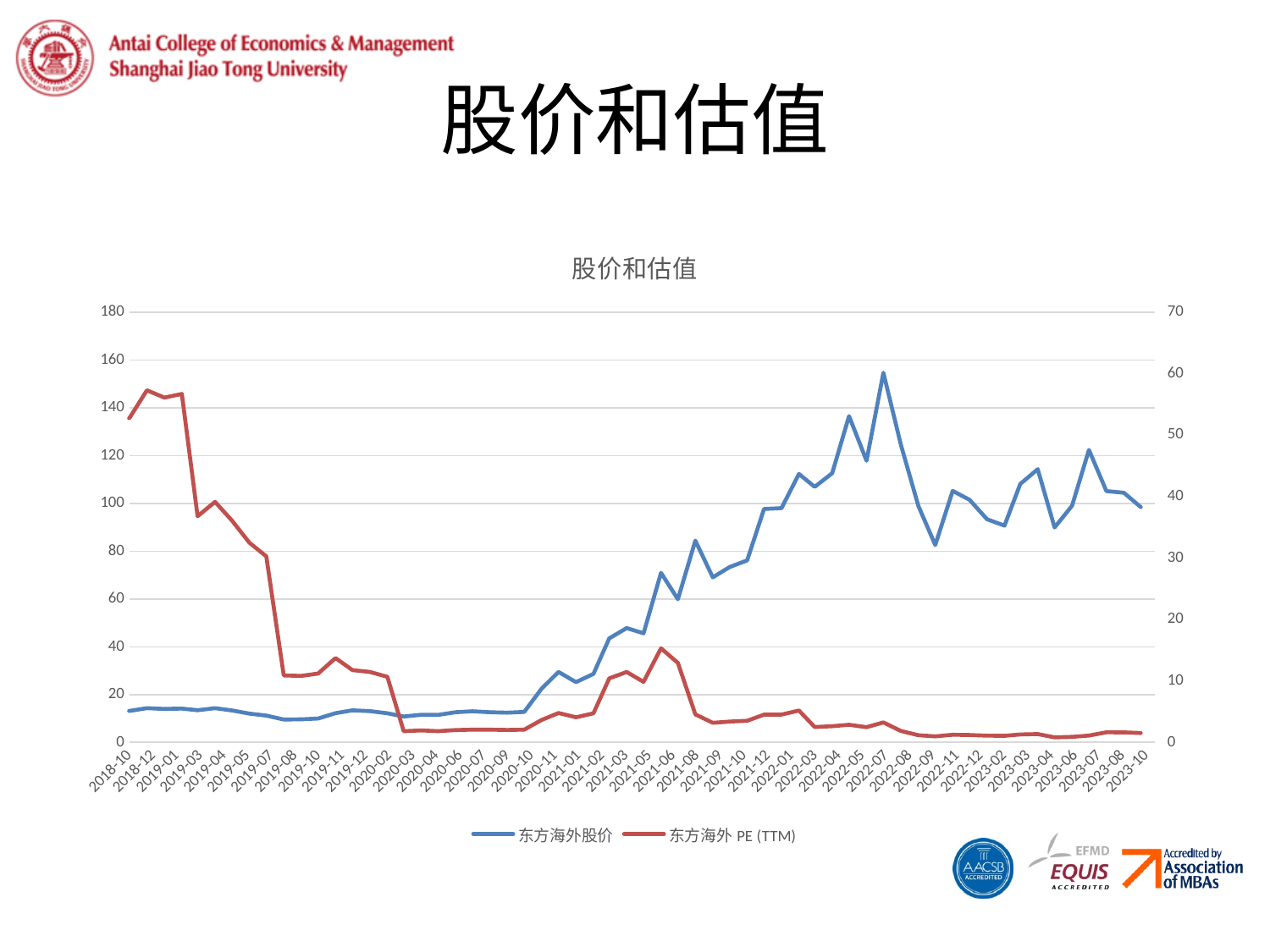
At 2018-10, which line is plotted higher on the chart, 东方海外股价 or 东方海外 PE (TTM)? 东方海外 PE (TTM) Reading against the left axis, is the value of 东方海外股价 at 2018-10 greater or less than 20? less Is the value of 东方海外 PE (TTM) at 2023-10 greater or less than 10? less At which date does the 东方海外股价 line reach its highest point? 2022-07 Which series is drawn in red according to the legend? 东方海外 PE (TTM) What kind of chart is shown on the slide? line chart How many series does the chart's legend list? 2 What is the title of the chart? 股价和估值 Reading against the left axis, is the value of 东方海外股价 at 2022-07 greater or less than 140? greater Does the 东方海外 PE (TTM) line rise or fall overall from 2018-10 to 2020-03? fall Does the 东方海外股价 line rise or fall overall from 2020-10 to 2022-07? rise At 2023-10, which line is plotted higher on the chart, 东方海外股价 or 东方海外 PE (TTM)? 东方海外股价